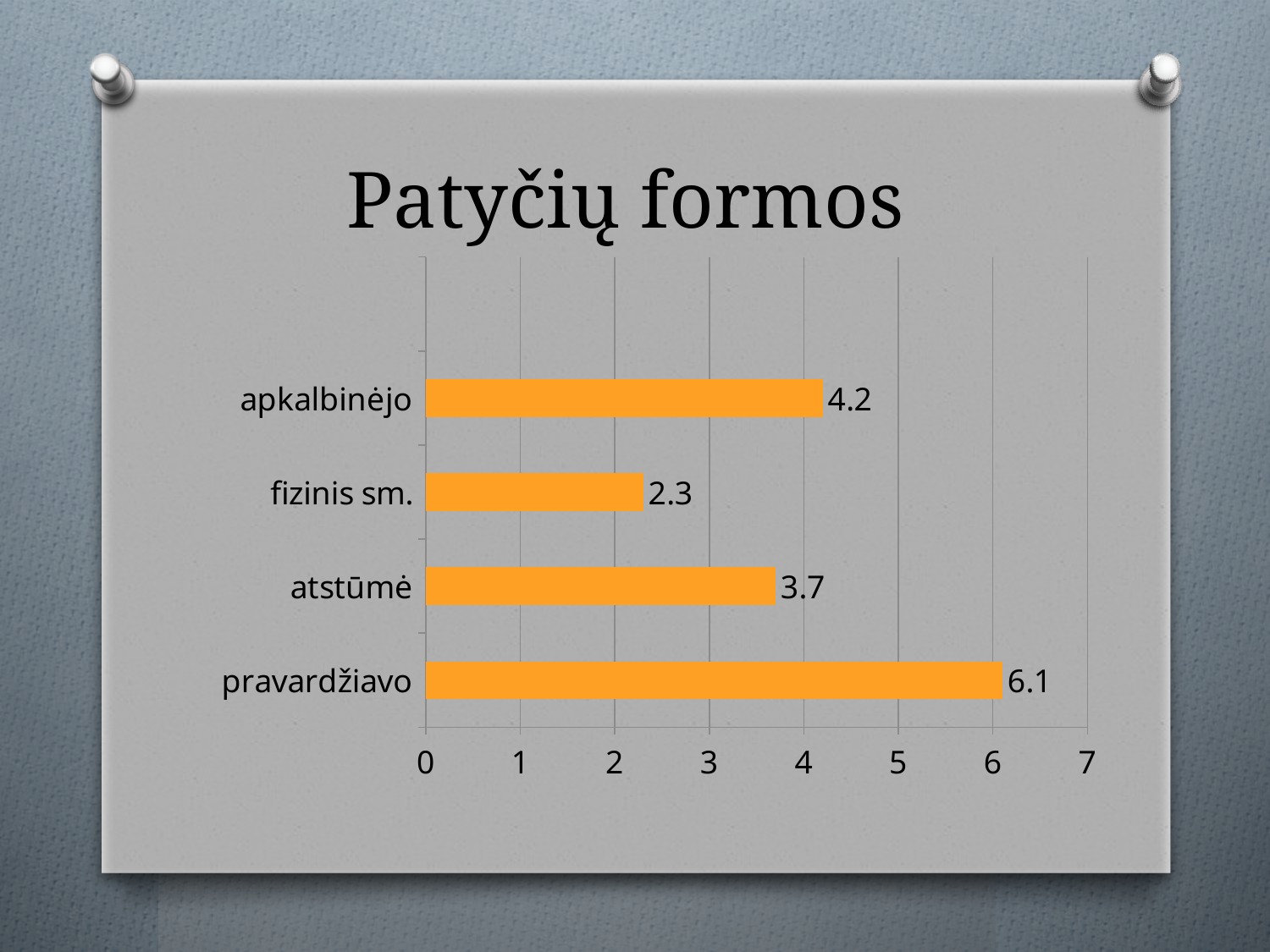
What is the value for apkalbinėjo? 4.2 Which category has the lowest value? fizinis sm. Which category has the highest value? pravardžiavo What is the value for fizinis sm.? 2.3 What kind of chart is shown on the slide? bar chart What is the difference between the values for pravardžiavo and fizinis sm.? 3.8 What is the difference between the values for apkalbinėjo and atstūmė? 0.5 Which is larger, the value for atstūmė or the value for apkalbinėjo? apkalbinėjo How many categories are shown in the chart? 4 Is the value for pravardžiavo greater or less than 5? greater What is the value for atstūmė? 3.7 What is the value for pravardžiavo? 6.1